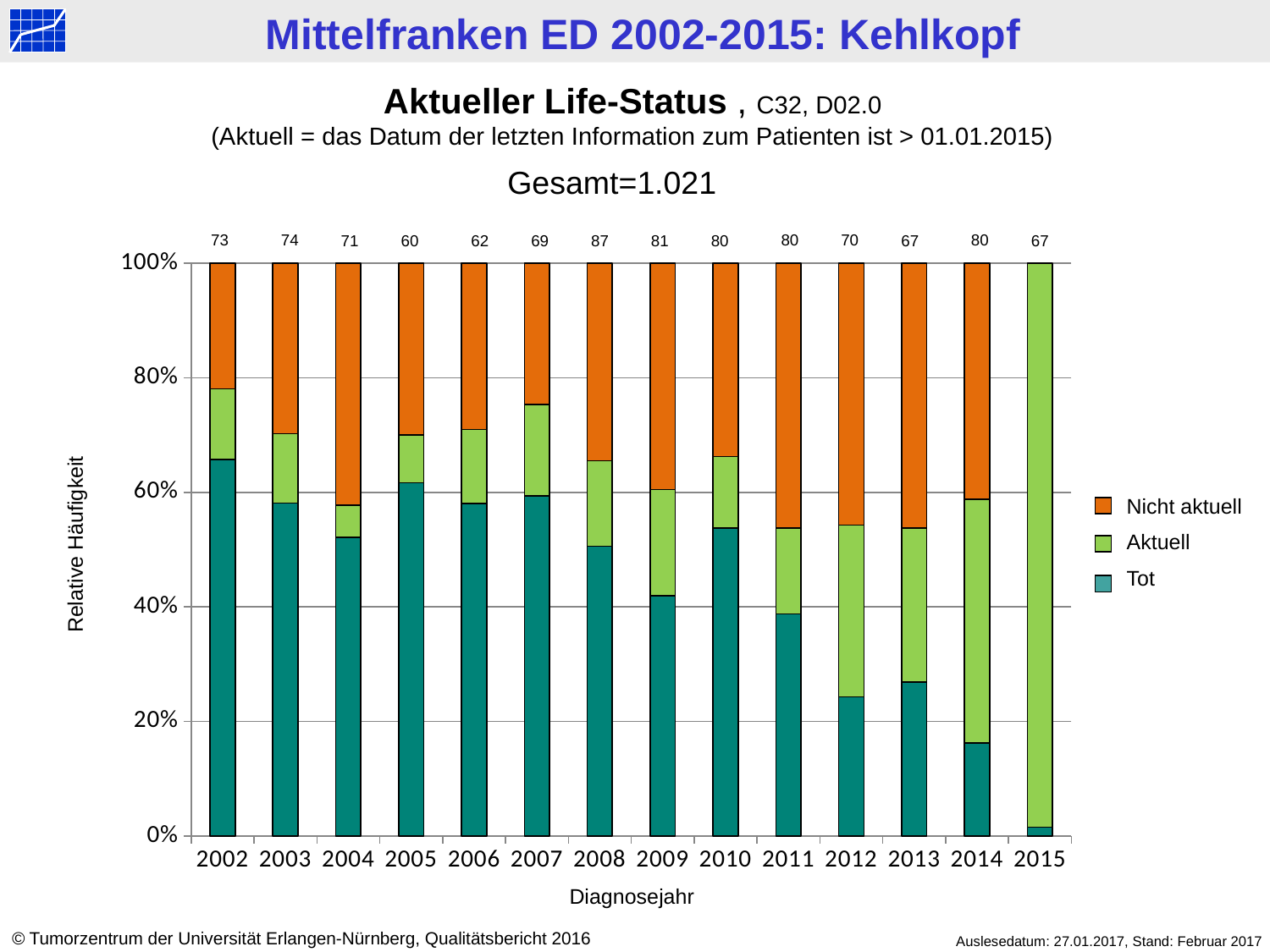
What is the difference between the numbers printed above the bars for 2008 and 2005? 27 What is the title of the x axis? Diagnosejahr What is the number printed above the bar for 2005? 60 Which diagnosis year has the highest number printed above its bar? 2008 Which diagnosis year has the lowest number printed above its bar? 2005 Is the share of 'Tot' for 2002 greater or less than 60%? greater How many series does the legend list? 3 Is the share of 'Tot' for 2014 greater or less than 20%? less How many diagnosis years (categories) are shown on the x axis? 14 Which year has a larger number printed above its bar, 2003 or 2012? 2003 What is the number printed above the bar for 2008? 87 What kind of chart is shown on the slide? stacked bar chart